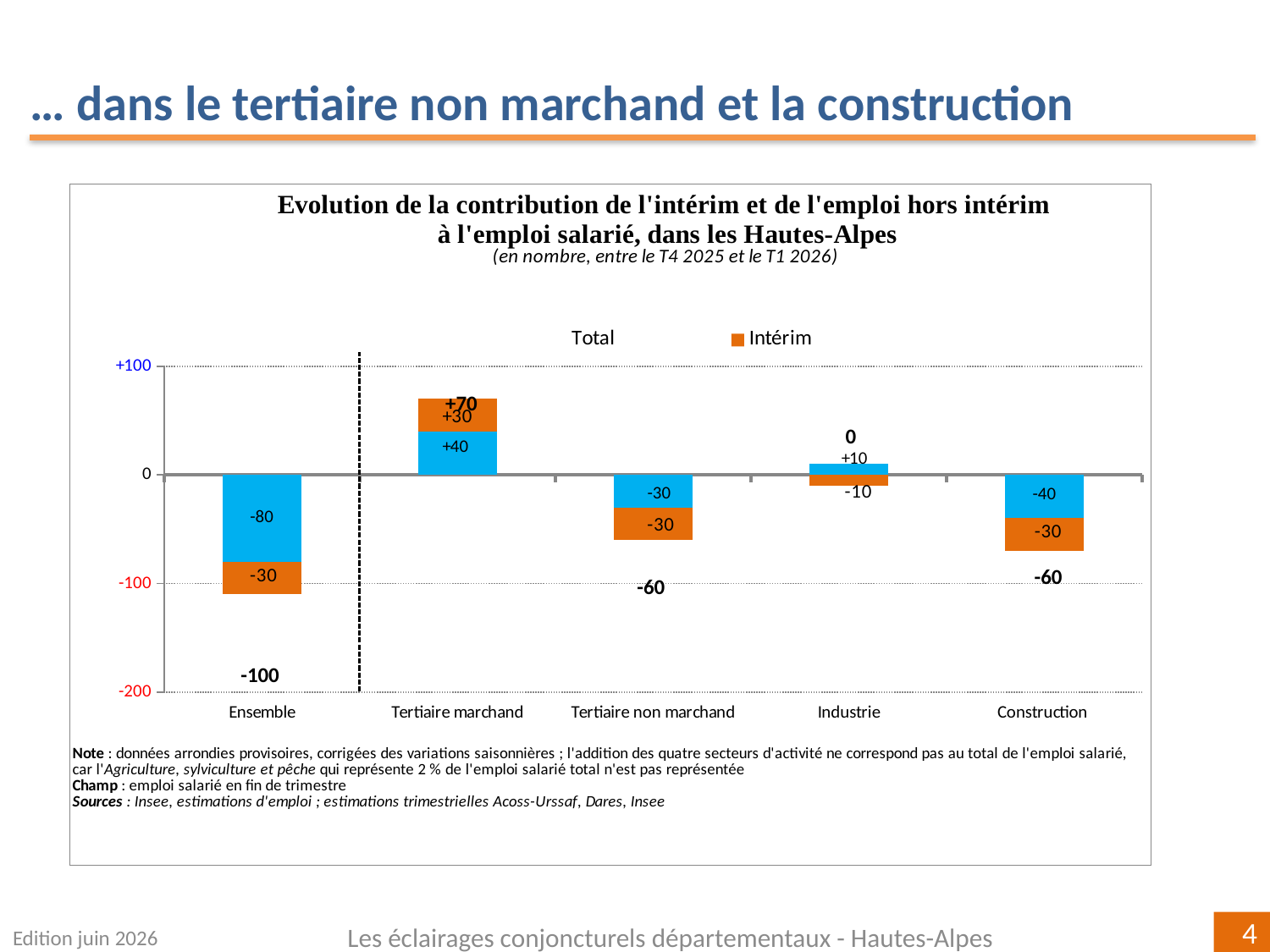
What is the Intérim value for Construction? -30 Which category has the lowest total value? Ensemble What kind of chart is this? Bar chart What is the total value shown for Industrie? 0 What is the difference between the total for Tertiaire marchand and the total for Tertiaire non marchand? 130 How many entries does the legend list? 2 Which is larger, the Intérim value for Tertiaire marchand or the Intérim value for Industrie? Tertiaire marchand What is the total value shown for Ensemble? -100 How many categories are shown on the x axis? 5 What is the total value shown for Tertiaire marchand? +70 What is the Intérim value for Tertiaire non marchand? -30 Which category has the highest total value? Tertiaire marchand